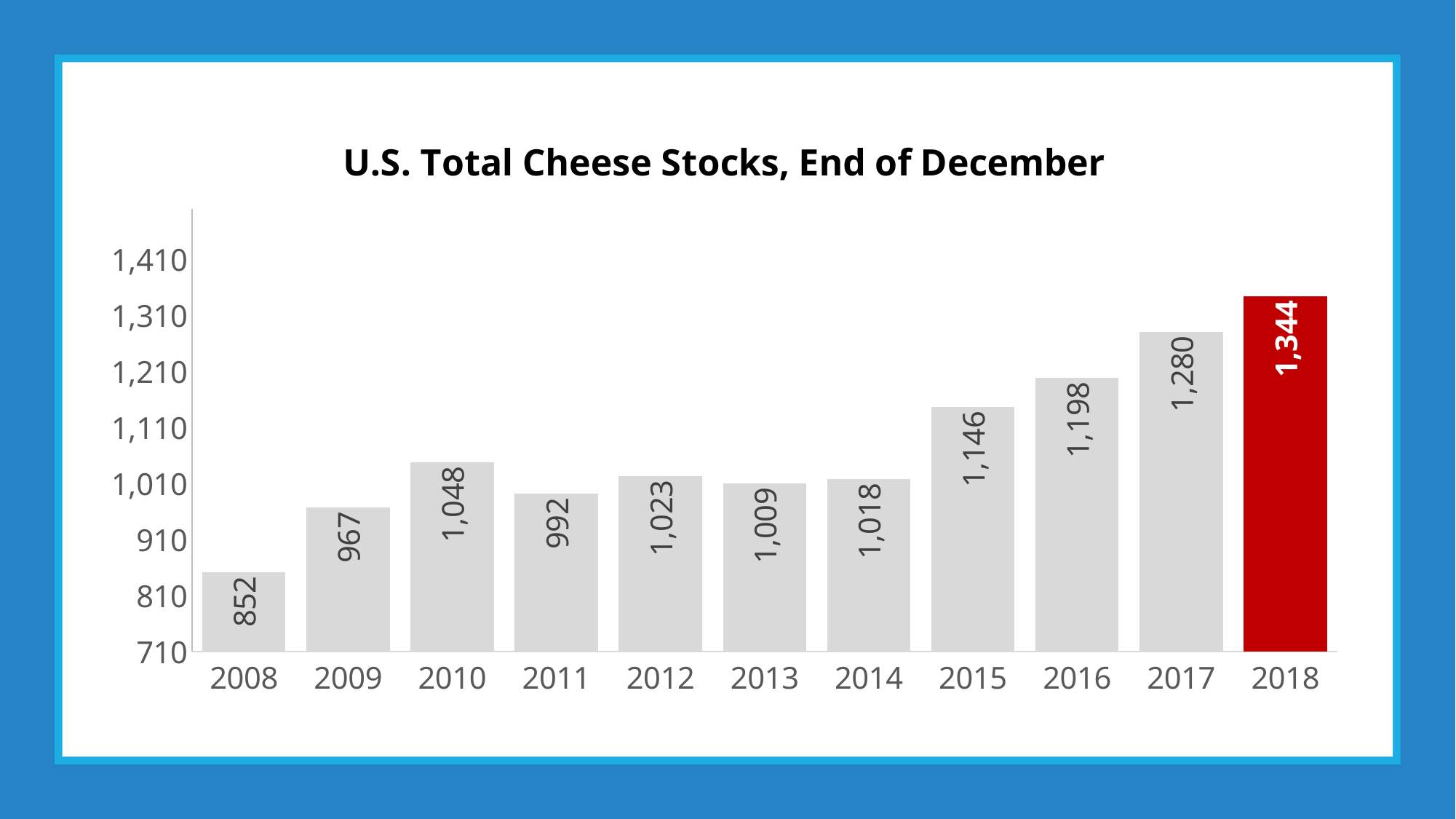
What is the value for 2008? 852 Which bar is coloured red? 2018 What is the value for 2013? 1,009 Which year has the lowest value? 2008 Is the value for 2016 greater or less than 1,110? greater What is the difference between the values for 2010 and 2011? 56 How many years are shown on the x axis? 11 Which year has the highest value? 2018 Which is larger, the value for 2012 or the value for 2014? 2012 What kind of chart is this? bar chart What is the difference between the values for 2018 and 2017? 64 What is the value for 2018? 1,344